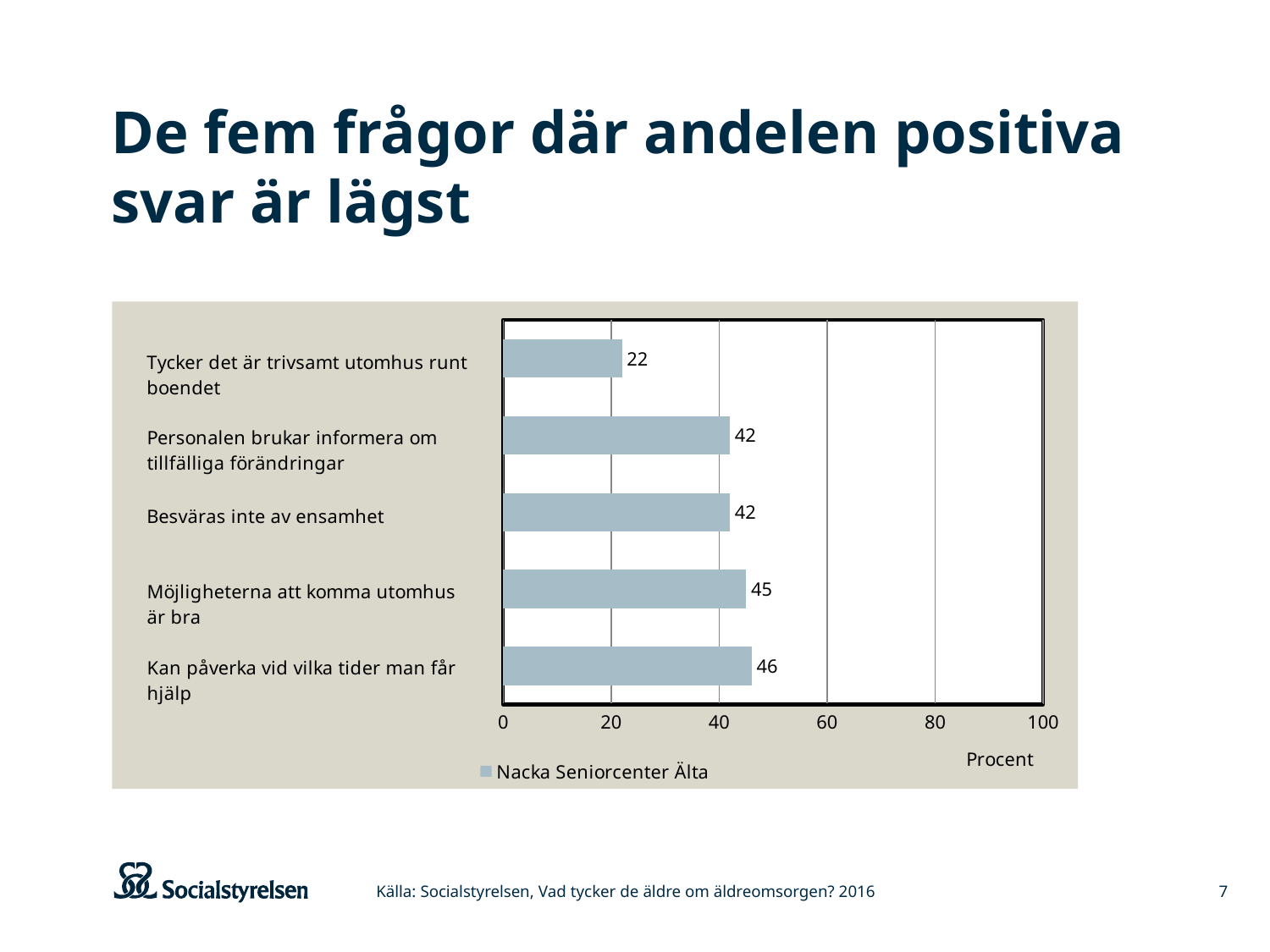
What series name does the legend show? Nacka Seniorcenter Älta What is the difference between the values for "Kan påverka vid vilka tider man får hjälp" and "Tycker det är trivsamt utomhus runt boendet"? 24 What is the value for "Besväras inte av ensamhet"? 42 What is the value for "Möjligheterna att komma utomhus är bra"? 45 Is the value for "Möjligheterna att komma utomhus är bra" greater or less than 60? less What is the value for "Kan påverka vid vilka tider man får hjälp"? 46 Which category has the highest value? Kan påverka vid vilka tider man får hjälp How many categories are shown in the chart? 5 Which is larger: the value for "Personalen brukar informera om tillfälliga förändringar" or the value for "Tycker det är trivsamt utomhus runt boendet"? Personalen brukar informera om tillfälliga förändringar What is the value for "Tycker det är trivsamt utomhus runt boendet"? 22 What kind of chart is shown on the slide? bar chart Which category has the lowest value? Tycker det är trivsamt utomhus runt boendet